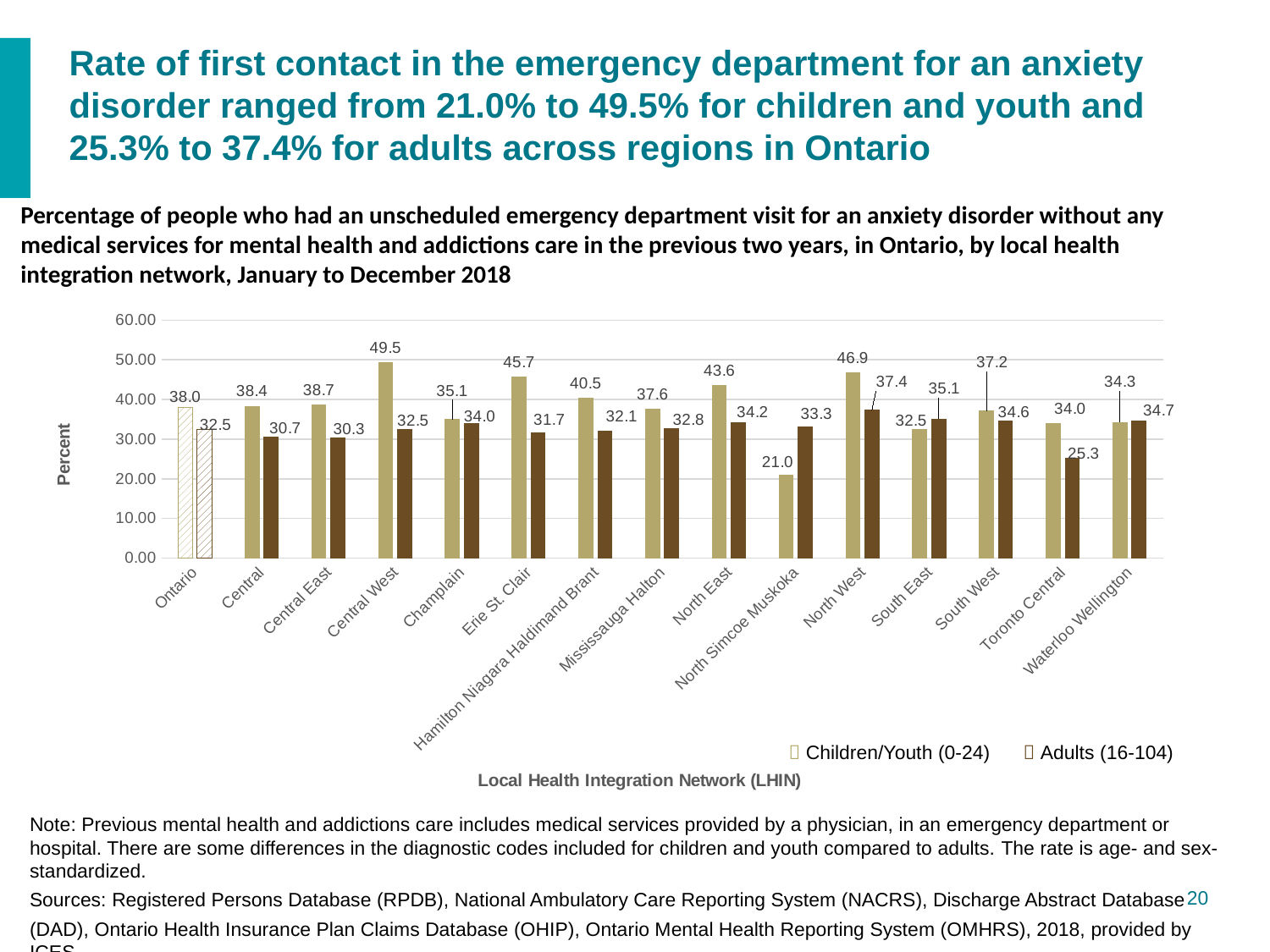
What is the Adults (16-104) value for Toronto Central? 25.3 How many series does the legend list? 2 Which LHIN has the lowest Adults (16-104) value? Toronto Central What is the difference between the Children/Youth (0-24) and Adults (16-104) values for Central West? 17.0 For South East, which is larger: the Children/Youth (0-24) value or the Adults (16-104) value? Adults (16-104) What is the label of the y axis? Percent How many LHIN categories (including Ontario) are shown on the x axis? 15 Which LHIN has the highest Adults (16-104) value? North West What is the Children/Youth (0-24) value for North Simcoe Muskoka? 21.0 What kind of chart is shown on the slide? Bar chart What is the Children/Youth (0-24) value for Central West? 49.5 Which LHIN has the highest Children/Youth (0-24) value? Central West